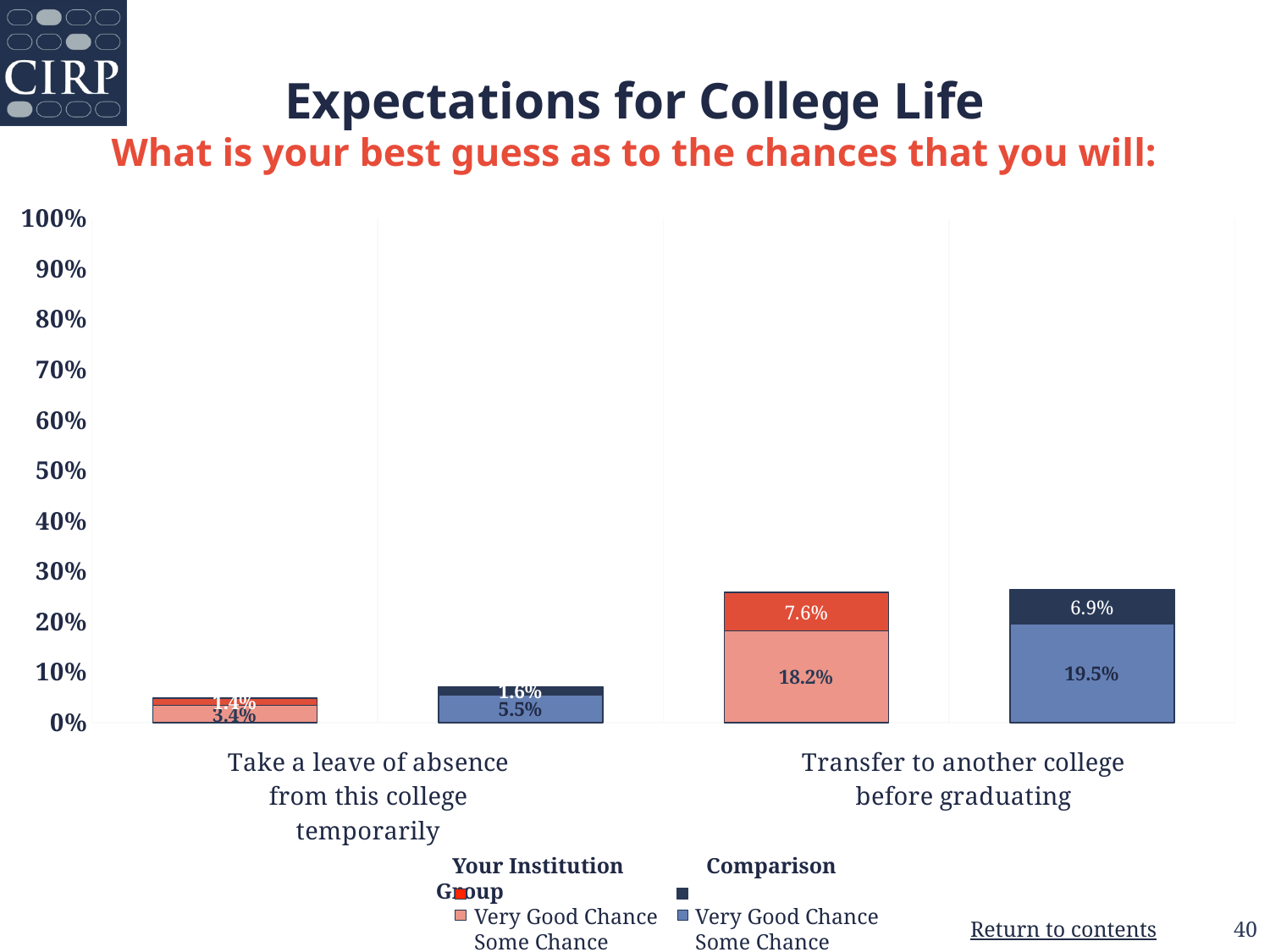
Is the total stacked bar for the Comparison Group for "Transfer to another college before graduating" greater or less than 30%? less How many series does the chart's legend list? 4 What kind of chart is shown on the slide? Stacked bar chart What is the Some Chance value for the Comparison Group for "Take a leave of absence from this college temporarily"? 5.5% What is the Very Good Chance value for the Comparison Group for "Transfer to another college before graduating"? 6.9% What is the Some Chance value for Your Institution for "Transfer to another college before graduating"? 18.2% What is the total of the stacked bar for the Comparison Group for "Take a leave of absence from this college temporarily"? 7.1% What is the difference between the Some Chance values for the Comparison Group and Your Institution for "Transfer to another college before graduating"? 1.3% What is the total of the stacked bar for Your Institution for "Transfer to another college before graduating"? 25.8% How many categories are shown on the x axis of the chart? 2 What is the Very Good Chance value for Your Institution for "Transfer to another college before graduating"? 7.6% Which is larger for "Transfer to another college before graduating": the Very Good Chance value for Your Institution or for the Comparison Group? Your Institution